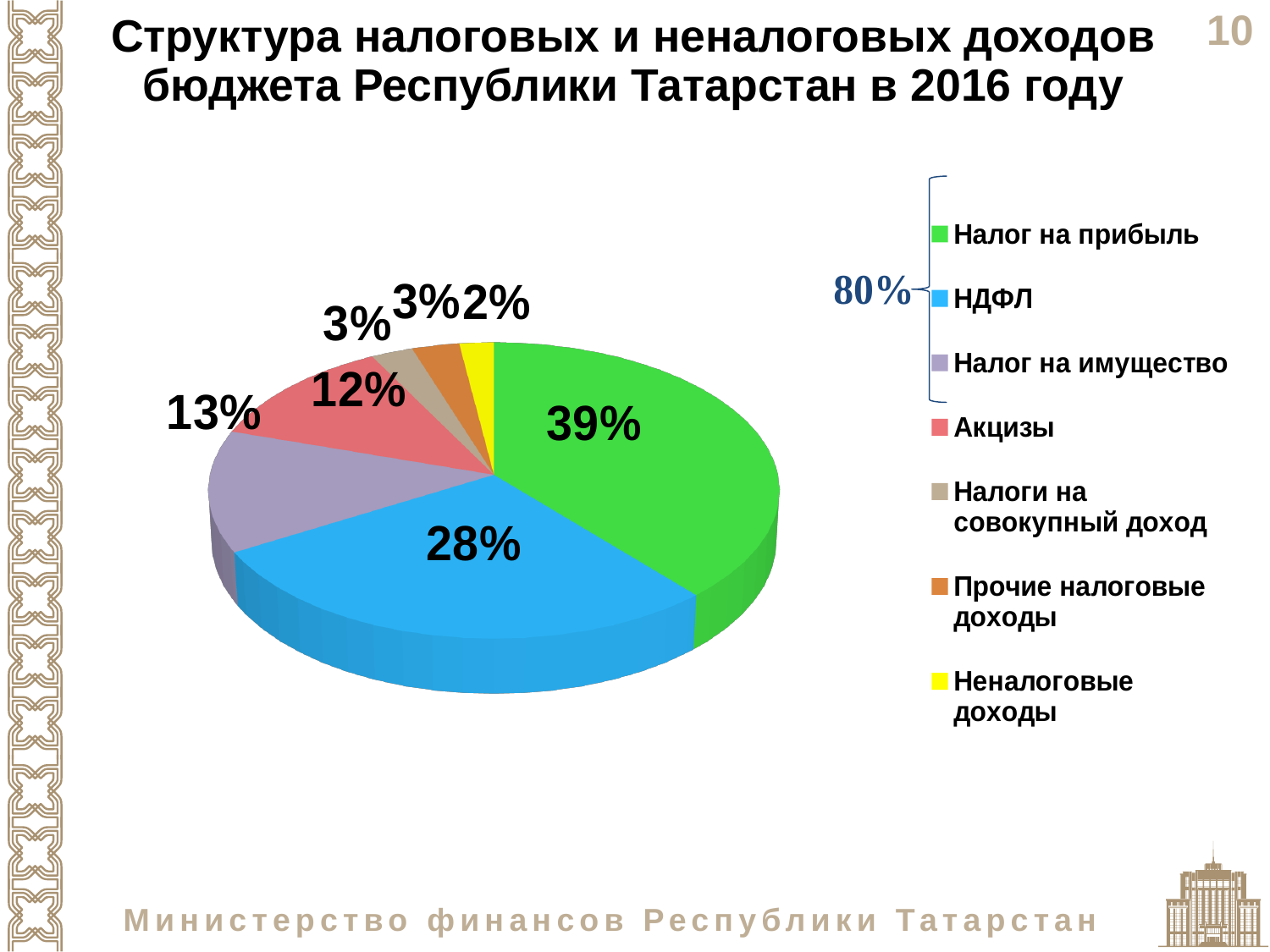
Which is larger, the share for Налог на имущество or the share for Акцизы? Налог на имущество Which category has the largest share of the pie? Налог на прибыль What share does НДФЛ account for? 28% What share of the budget revenue does Налог на прибыль account for? 39% What kind of chart is shown on the slide? pie chart What share does Акцизы account for? 12% What share does Неналоговые доходы account for? 2% Which category has the smallest share of the pie? Неналоговые доходы What share does Налог на имущество account for? 13% What combined share is indicated by the bracket grouping Налог на прибыль, НДФЛ and Налог на имущество in the legend? 80% What is the difference in percentage points between Налог на прибыль and НДФЛ? 11 How many categories does the legend list? 7